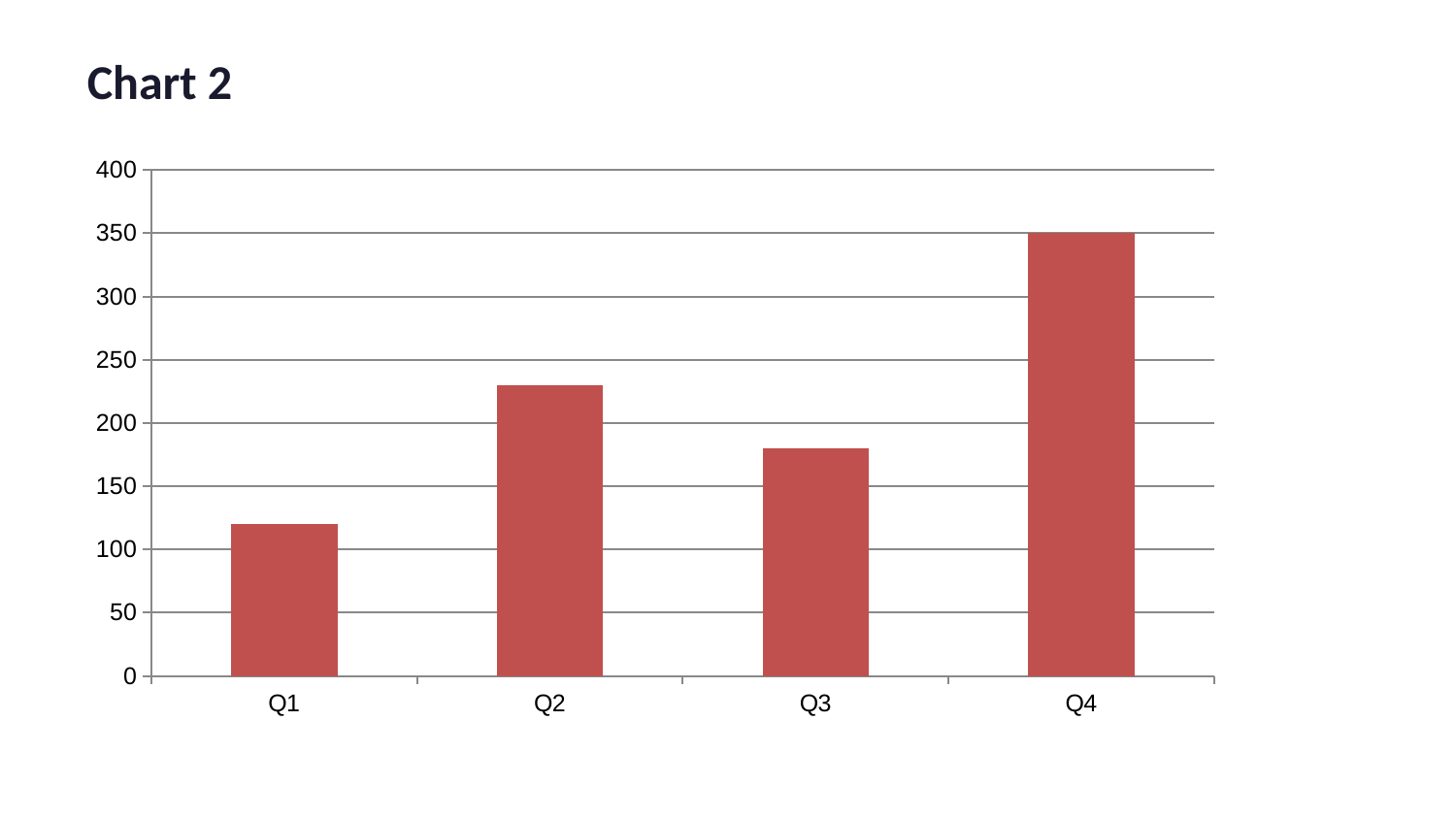
Does the value rise or fall from Q2 to Q3? fall What kind of chart is shown on the slide? bar chart Is the value for Q3 greater or less than 200? less What is the title of the chart? Chart 2 Which category has the lowest value? Q1 How many categories are shown on the x axis? 4 Is the value for Q1 greater or less than 150? less Is the value for Q4 greater or less than 300? greater Which category has the highest value? Q4 Which is larger, the value for Q2 or the value for Q3? Q2 What is the value for Q4? 350